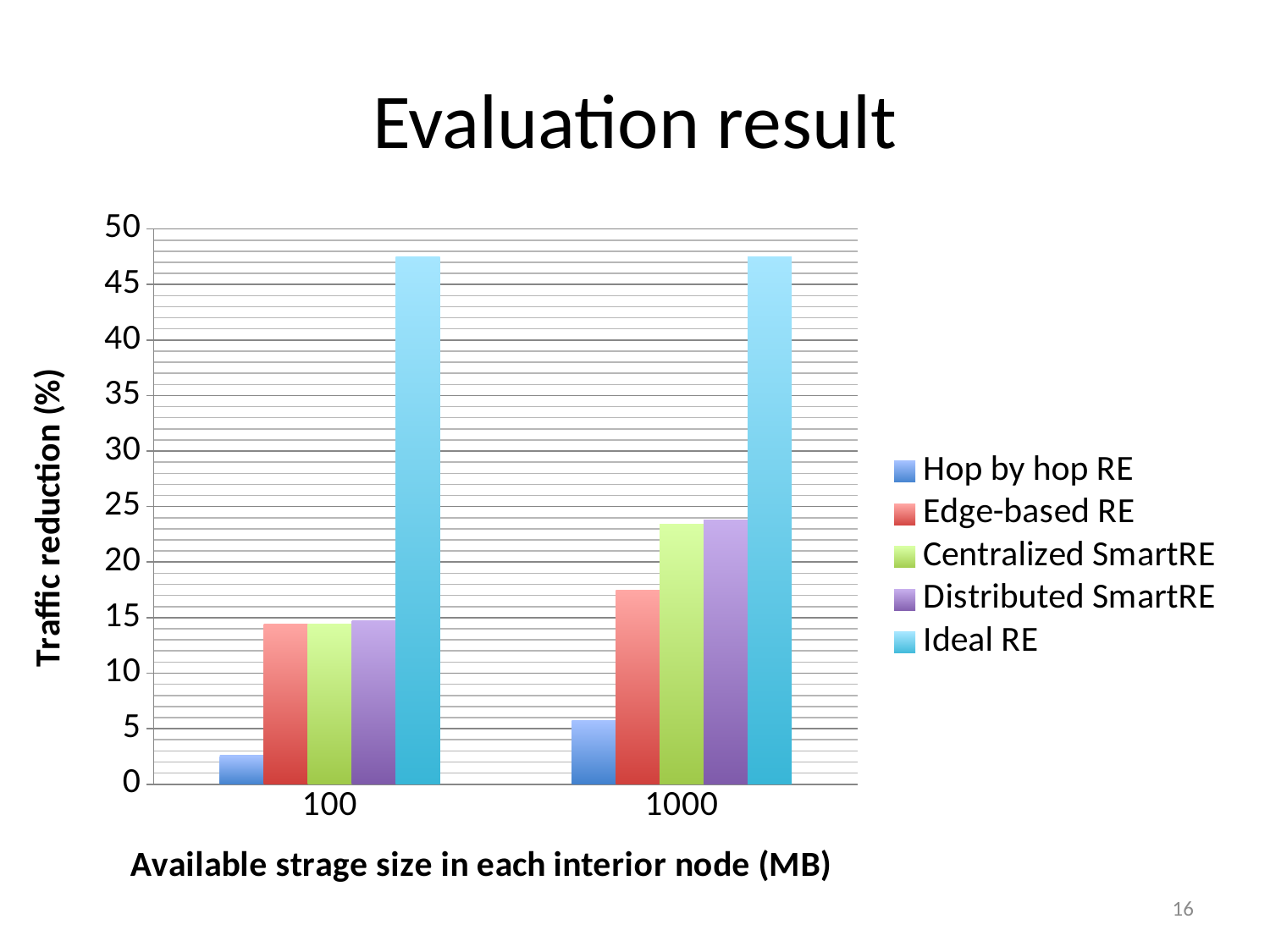
Is the value for Ideal RE at 100 MB greater or less than 45? greater At 1000 MB, which is larger: Edge-based RE or Centralized SmartRE? Centralized SmartRE How many storage-size categories are shown on the x axis? 2 Is the value for Edge-based RE at 1000 MB greater or less than 15? greater Does the traffic reduction for Distributed SmartRE rise or fall from 100 MB to 1000 MB? rise How many series does the legend list? 5 Is the value for Hop by hop RE at 100 MB greater or less than 5? less Which series has the highest traffic reduction at 100 MB? Ideal RE What kind of chart is shown on the slide? bar chart Which series has the lowest traffic reduction at 1000 MB? Hop by hop RE What is the title of the y axis? Traffic reduction (%)